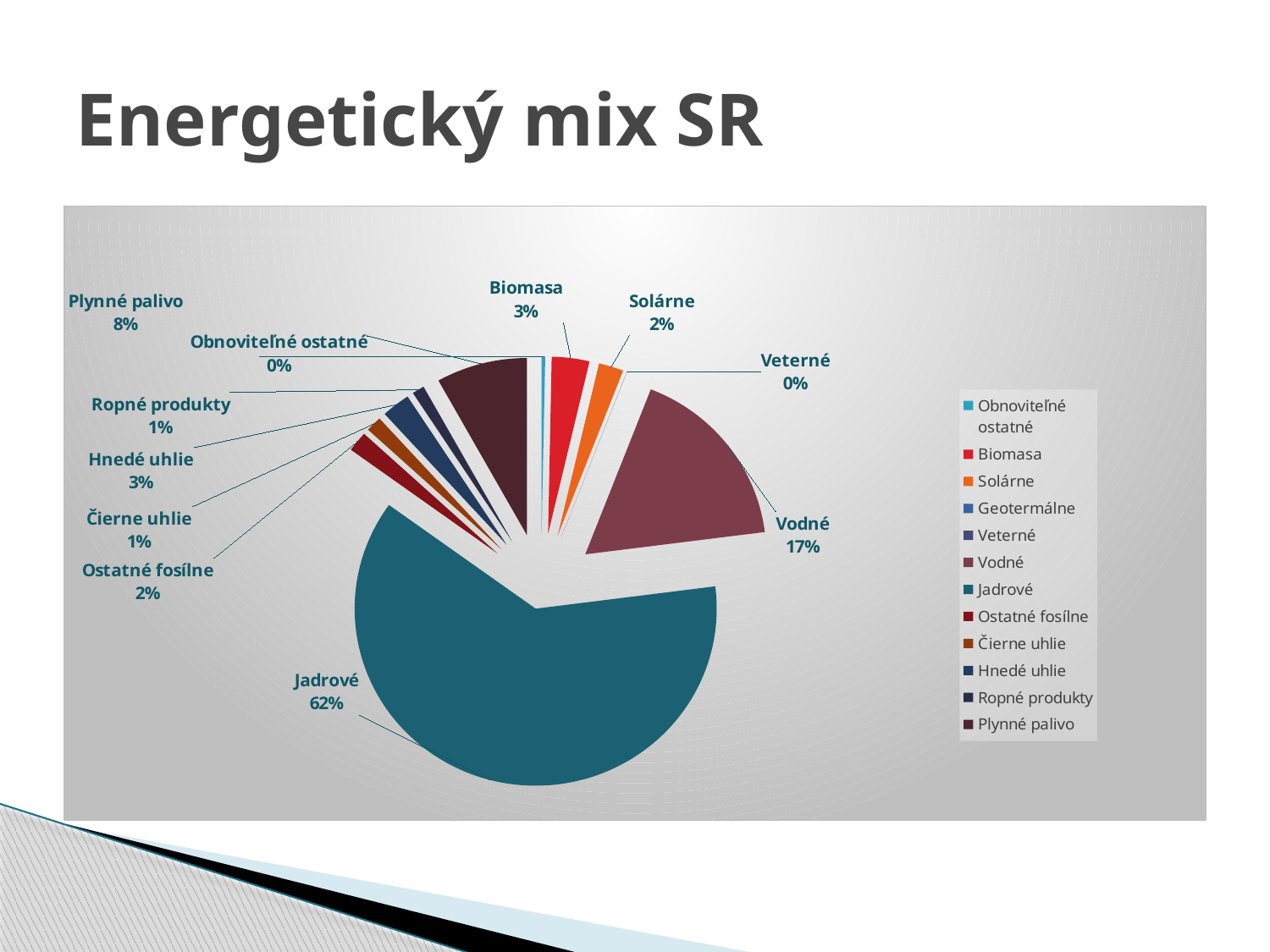
Which is larger, Vodné or Plynné palivo? Vodné What is the title of the slide containing the chart? Energetický mix SR What is the value shown for Hnedé uhlie? 3% What is the value shown for Solárne? 2% What share of the pie does Jadrové have? 62% Which category has the largest slice of the pie? Jadrové What kind of chart is shown on the slide? pie chart What is the difference between the Jadrové and Vodné shares? 45% What is the value shown for Biomasa? 3% What share of the pie does Vodné have? 17% How many entries does the legend list? 12 What is the value shown for Plynné palivo? 8%